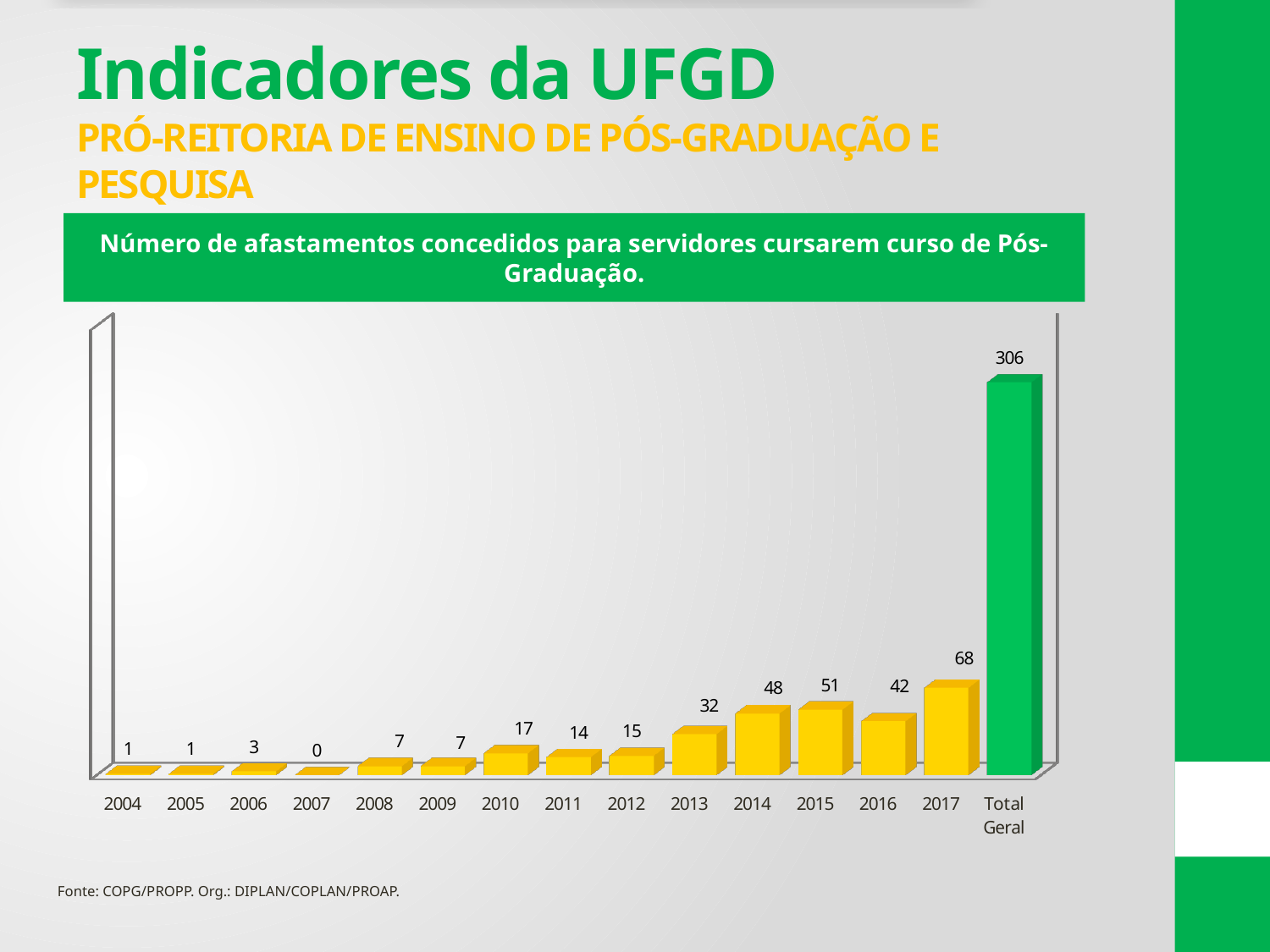
What is the title of the chart? Número de afastamentos concedidos para servidores cursarem curso de Pós-Graduação. What is the value for 2013? 32 What is the value shown for Total Geral? 306 Which year between 2004 and 2017 has the highest value? 2017 What is the value for 2017? 68 What is the difference between the values for 2017 and 2016? 26 Which is larger, the value for 2015 or the value for 2016? 2015 How many categories are shown on the x axis? 15 What kind of chart is shown on the slide? Bar chart What is the difference between the values for 2015 and 2014? 3 What is the value for 2007? 0 Which year has the lowest value? 2007